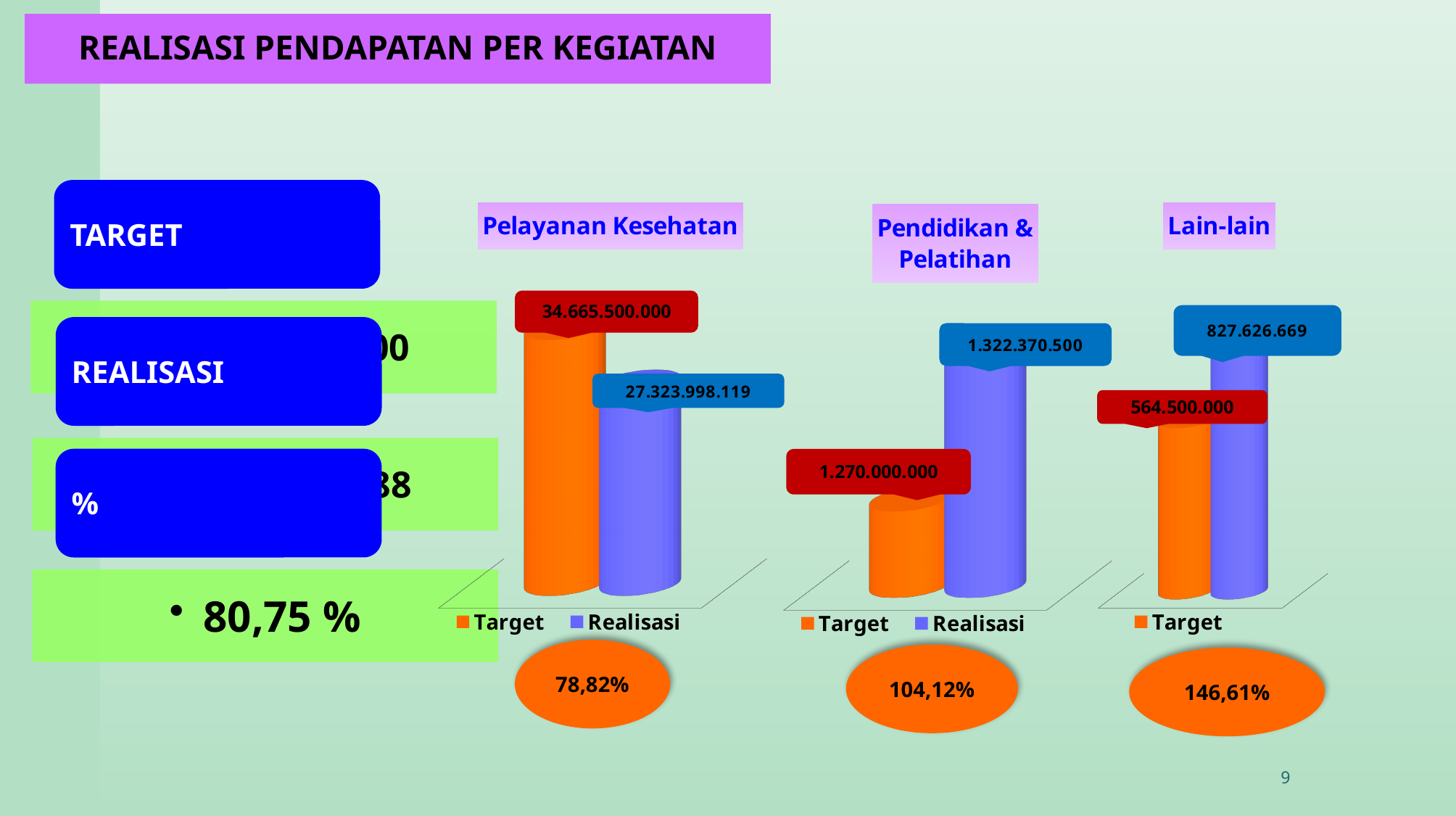
In the Pendidikan & Pelatihan chart, what is the value of the Target bar? 1.270.000.000 In the Pelayanan Kesehatan chart, what is the value of the Realisasi bar? 27.323.998.119 In the Pendidikan & Pelatihan chart, what is the value of the Realisasi bar? 1.322.370.500 What kind of chart is the Pendidikan & Pelatihan chart? Bar chart In the Lain-lain chart, what is the value of the Realisasi bar? 827.626.669 In the Pelayanan Kesehatan chart, what is the difference between the Target and Realisasi values? 7.341.501.881 In the Pendidikan & Pelatihan chart, which is larger, Target or Realisasi? Realisasi In the Pelayanan Kesehatan chart, what is the value of the Target bar? 34.665.500.000 In the Lain-lain chart, what is the value of the Target bar? 564.500.000 In the Pelayanan Kesehatan chart, which is larger, Target or Realisasi? Target How many series does the legend of the Pelayanan Kesehatan chart list? 2 In the Lain-lain chart, what is the difference between the Realisasi and Target values? 263.126.669